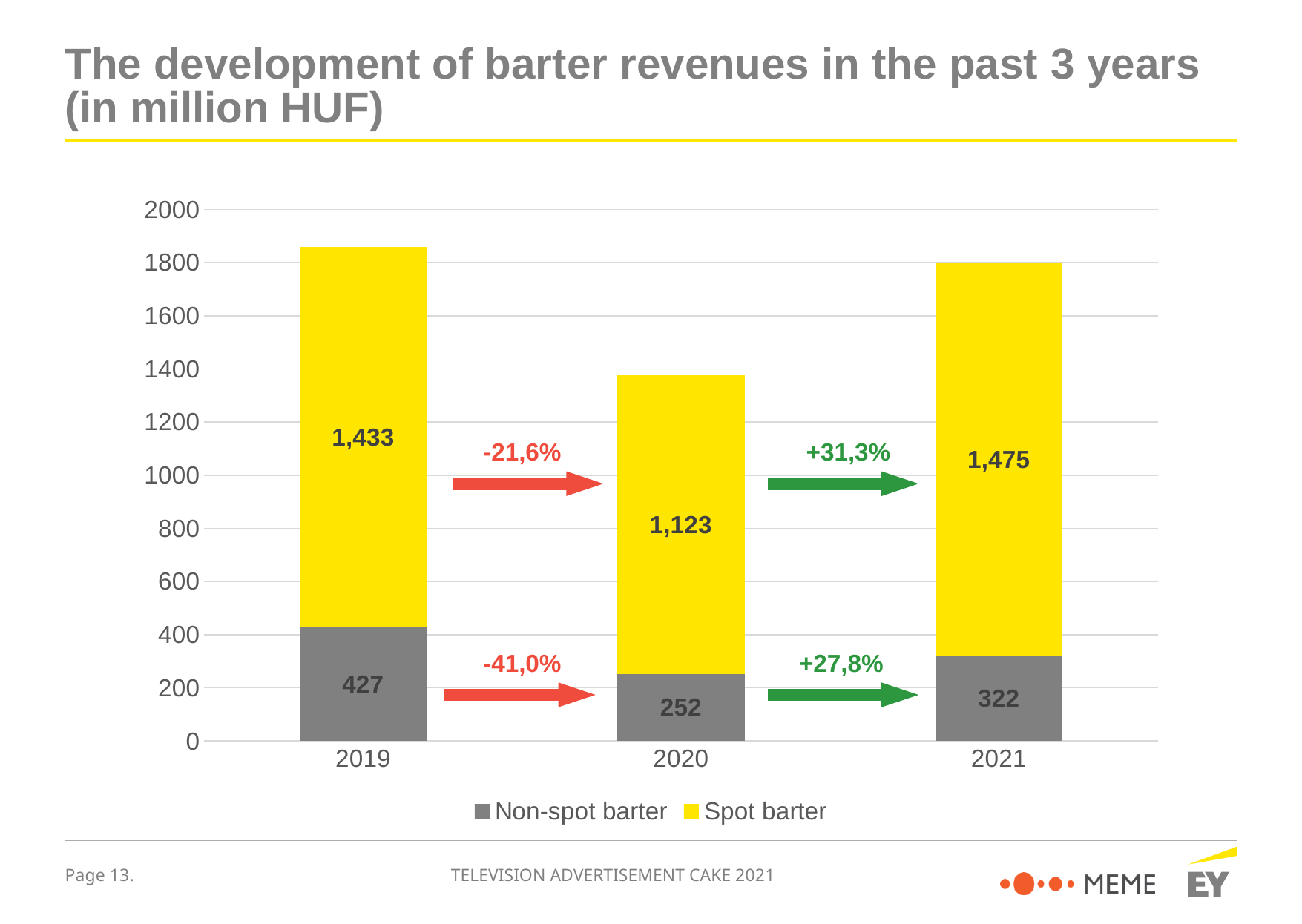
How many series does the legend list? 2 What kind of chart is shown on the slide? Stacked bar chart What percentage change is shown for Spot barter between 2019 and 2020? -21,6% Which is larger, the Non-spot barter value for 2019 or for 2021? 2019 What is the Non-spot barter value for 2021? 322 Which year has the highest Spot barter value? 2021 How many years are shown on the x axis? 3 What is the Spot barter value for 2019? 1,433 What is the difference between the Spot barter values for 2021 and 2020? 352 What is the Non-spot barter value for 2020? 252 What is the total of the stacked bar for 2020? 1,375 Which year has the lowest Non-spot barter value? 2020